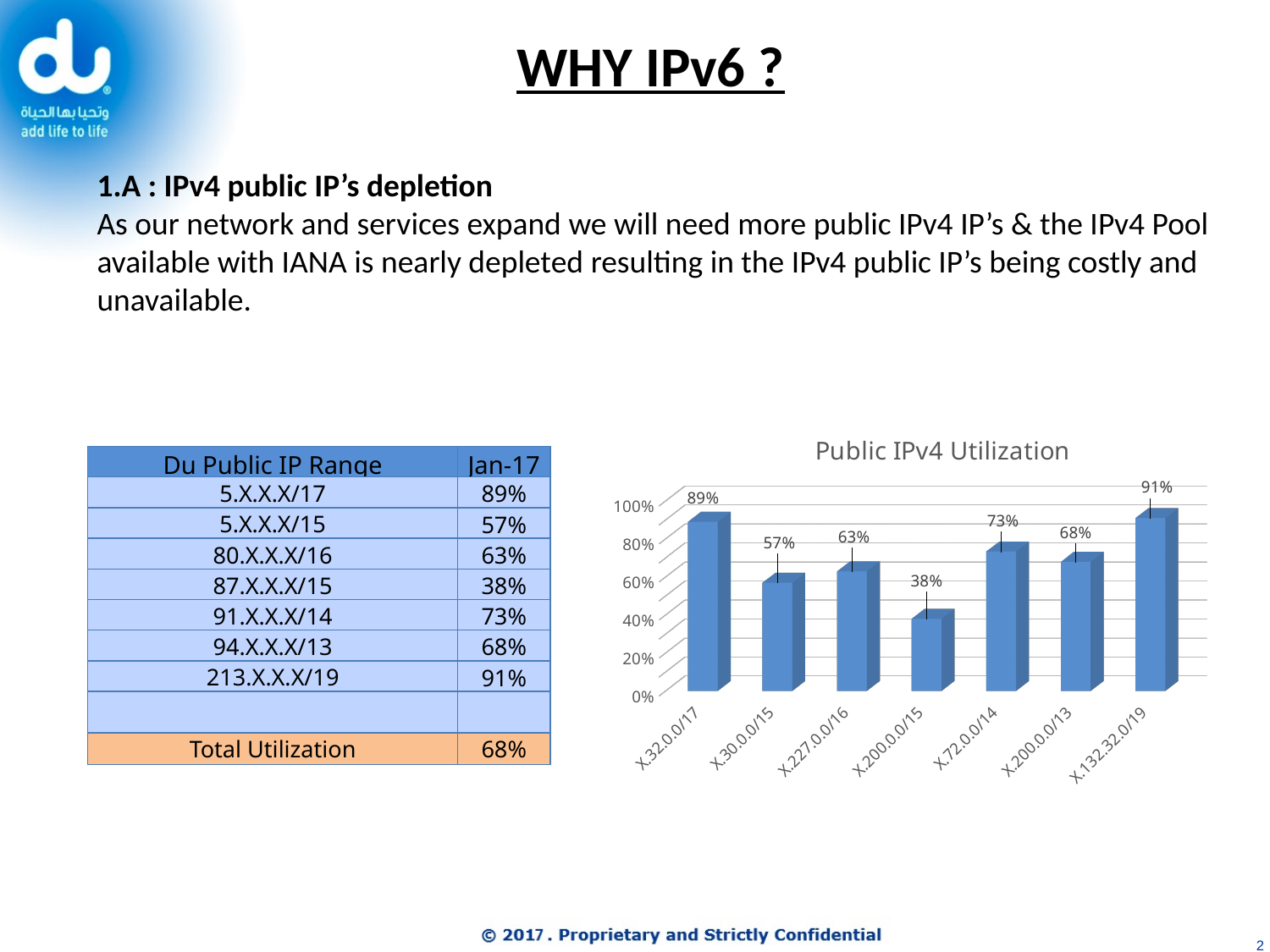
What kind of chart is the Public IPv4 Utilization chart? bar chart Which category has the lowest value in the Public IPv4 Utilization chart? X.200.0.0/15 Which is larger in the Public IPv4 Utilization chart, the value for X.30.0.0/15 or X.227.0.0/16? X.227.0.0/16 What is the difference between the values for X.72.0.0/14 and X.200.0.0/13 in the Public IPv4 Utilization chart? 5% What is the difference between the values for X.132.32.0/19 and X.200.0.0/15 in the Public IPv4 Utilization chart? 53% What is the value for X.32.0.0/17 in the Public IPv4 Utilization chart? 89% How many categories are shown in the Public IPv4 Utilization chart? 7 Is the value for X.200.0.0/13 greater or less than 60% in the Public IPv4 Utilization chart? greater Which category has the highest value in the Public IPv4 Utilization chart? X.132.32.0/19 What is the title of the chart on the slide? Public IPv4 Utilization What is the value for X.72.0.0/14 in the Public IPv4 Utilization chart? 73% What is the value for X.200.0.0/15 in the Public IPv4 Utilization chart? 38%